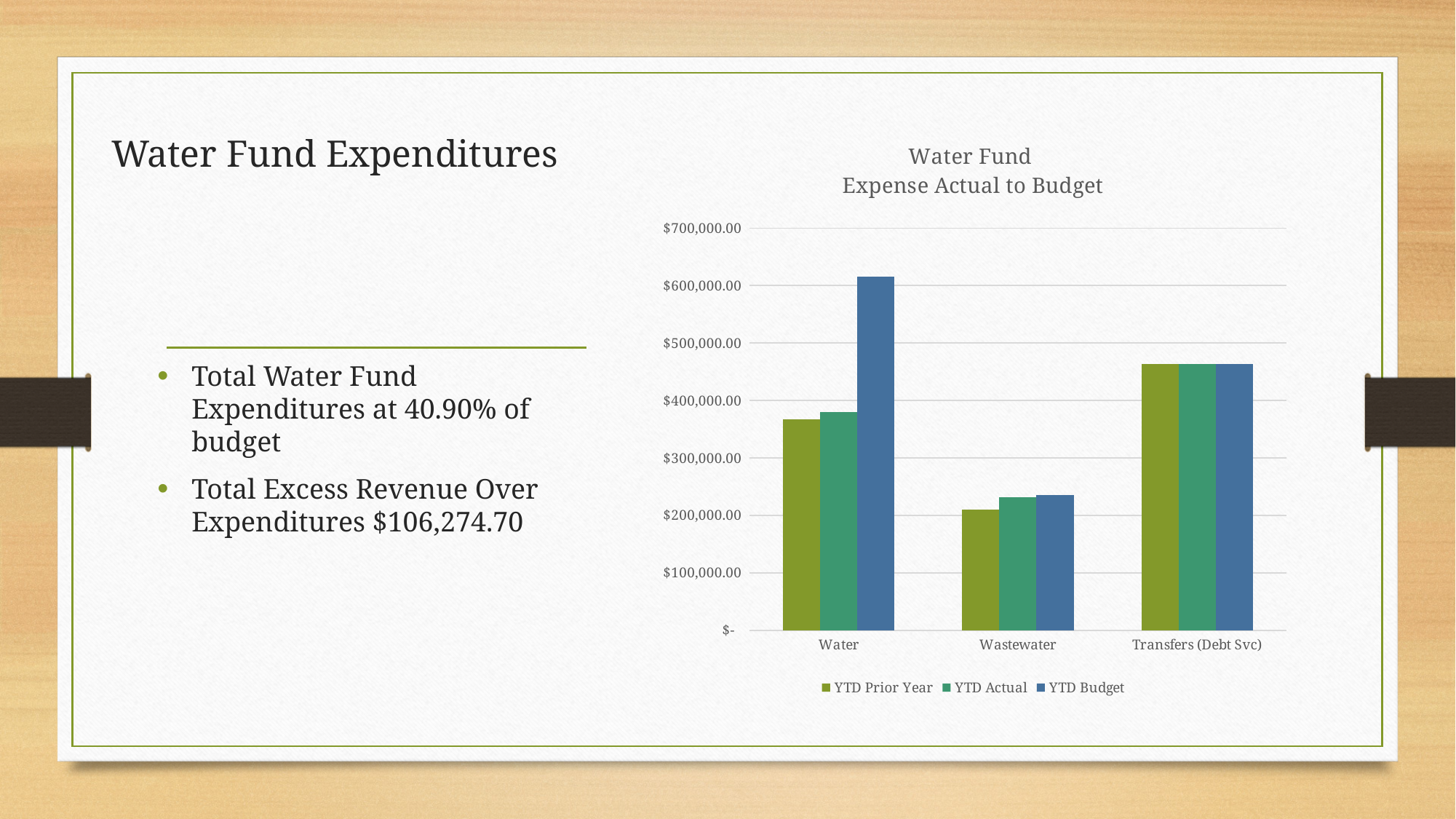
Is the YTD Budget value for Water greater or less than $600,000.00? greater Is the YTD Budget value for Transfers (Debt Svc) greater or less than $500,000.00? less Is the YTD Prior Year value for Water greater or less than $400,000.00? less Which category has the highest YTD Budget value? Water Which series is shown in blue in the chart? YTD Budget What is the title of the chart? Water Fund Expense Actual to Budget How many categories are shown on the x axis of the chart? 3 Which category has the lowest YTD Actual value? Wastewater Which category has the lowest YTD Prior Year value? Wastewater For Water, which is larger: YTD Budget or YTD Actual? YTD Budget How many series does the chart's legend list? 3 What kind of chart is shown on the slide? bar chart